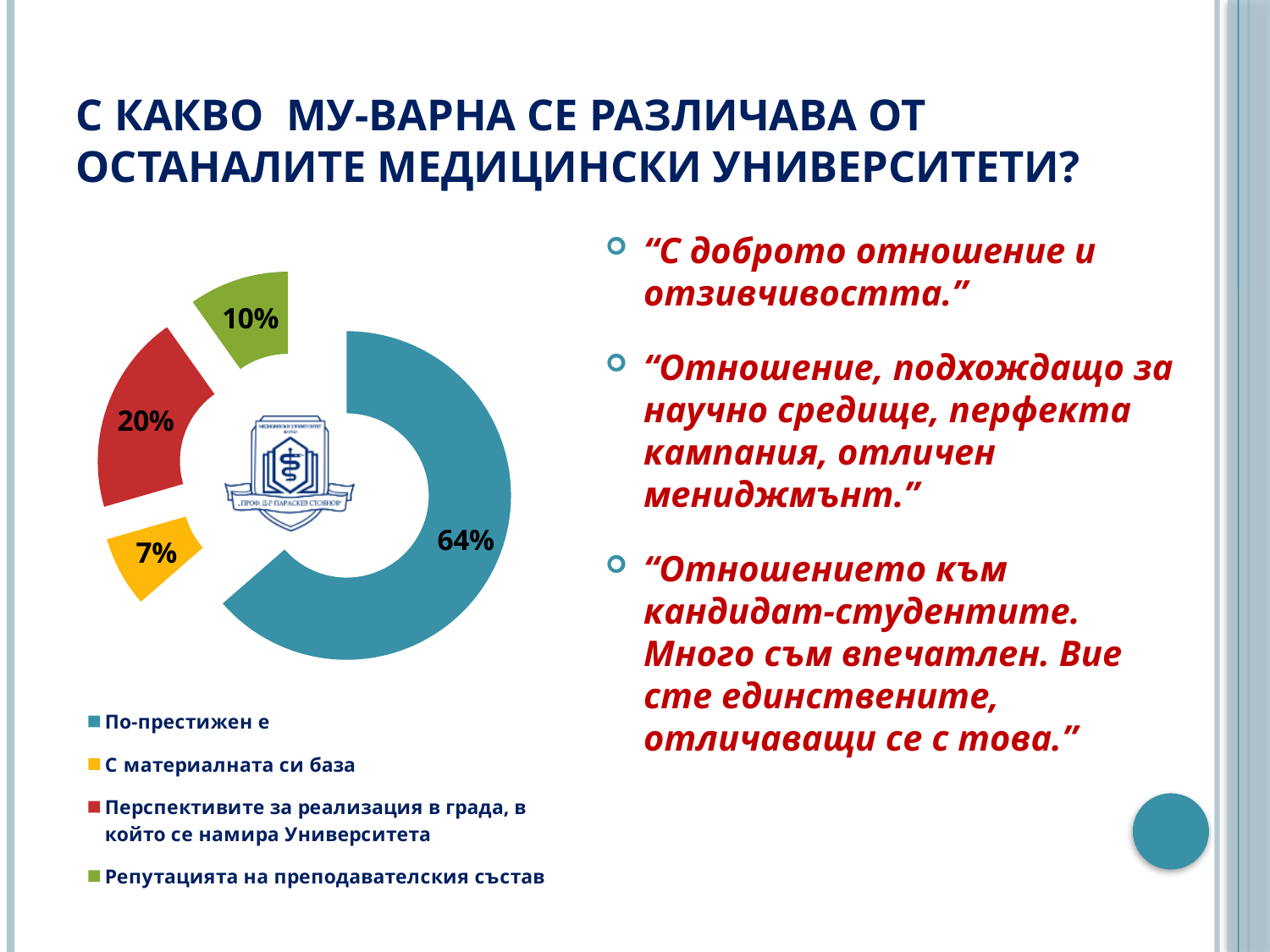
How many categories does the chart show? 4 What is the combined share of "Перспективите за реализация в града, в който се намира Университета" and "Репутацията на преподавателския състав"? 30% What is the difference in percentage points between "По-престижен е" and "Перспективите за реализация в града, в който се намира Университета"? 44 Which category has the largest share in the chart? По-престижен е What type of chart is shown on the slide? Doughnut (pie) chart Which is larger: the share for "Репутацията на преподавателския състав" or the share for "С материалната си база"? Репутацията на преподавателския състав What colour is the slice for "Перспективите за реализация в града, в който се намира Университета"? Red What percentage is shown for "Репутацията на преподавателския състав"? 10% What share of the doughnut chart is labelled "По-престижен е"? 64% Which category has the smallest share in the chart? С материалната си база What percentage is shown for "Перспективите за реализация в града, в който се намира Университета"? 20% What percentage is shown for "С материалната си база"? 7%